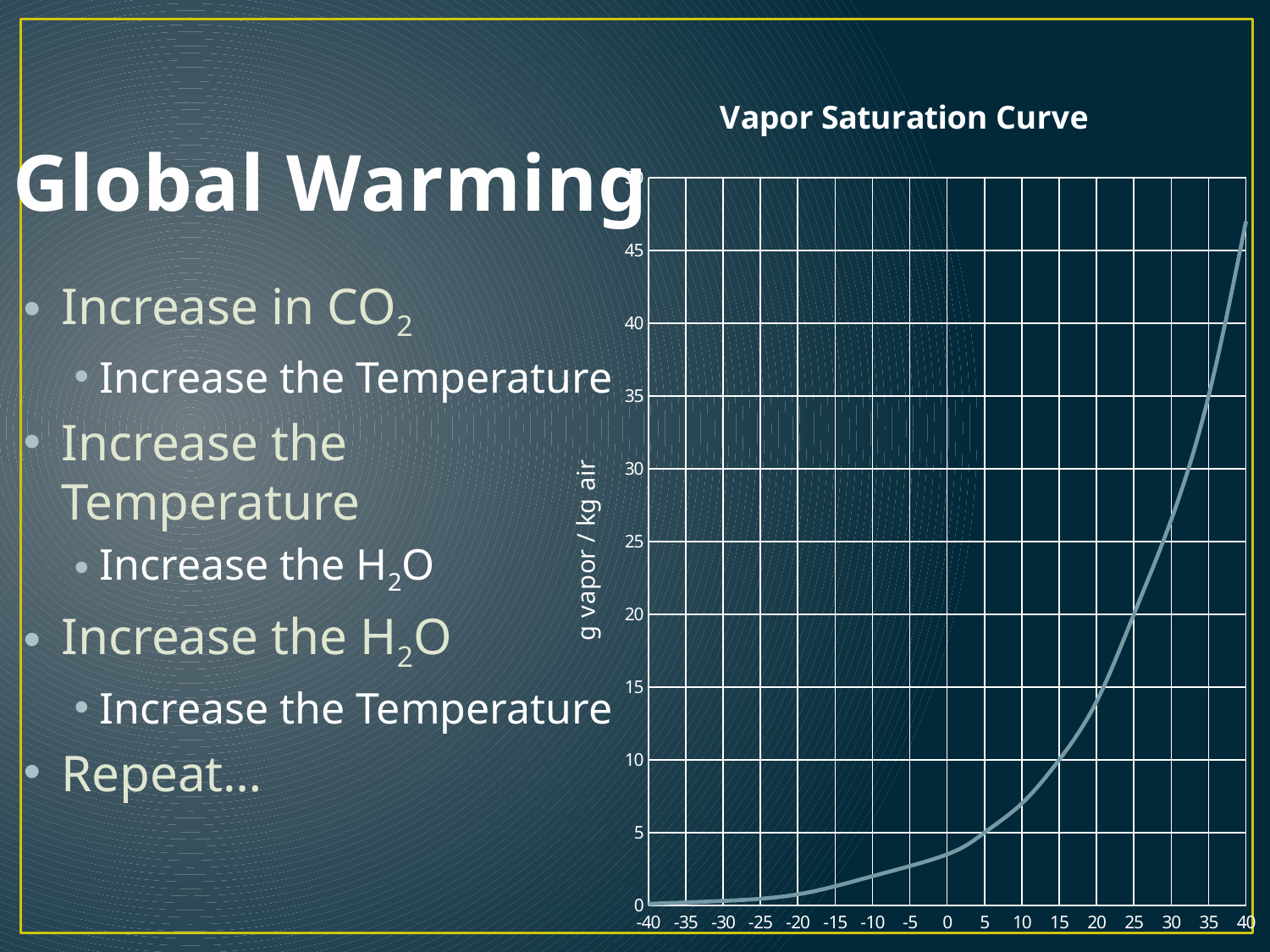
How many labelled tick marks are on the x-axis of the chart? 17 At which x-axis value is the Vapor Saturation Curve highest? 40 Which has the larger value on the Vapor Saturation Curve, x = 30 or x = 10? x = 30 What is the label on the vertical axis of the chart? g vapor / kg air At which x-axis value is the Vapor Saturation Curve lowest? -40 Is the value of the Vapor Saturation Curve at x = 0 greater or less than 5? less Is the value of the Vapor Saturation Curve at x = 10 greater or less than 10? less Is the value of the Vapor Saturation Curve at x = 40 greater or less than 45? greater What kind of chart is shown on the slide? line chart Do the values on the Vapor Saturation Curve rise or fall as the x-axis value increases from -40 to 40? rise What is the title of the chart? Vapor Saturation Curve